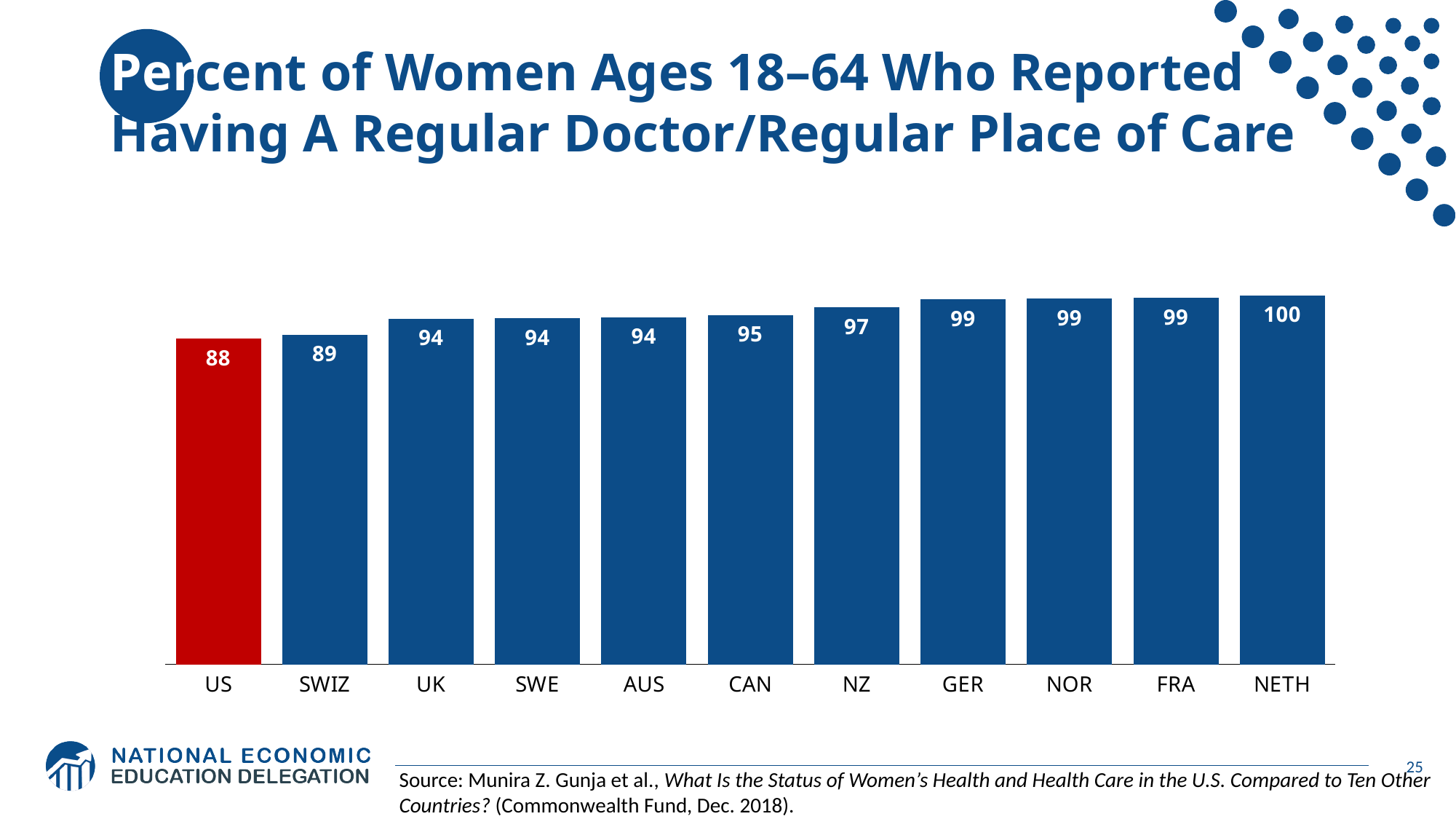
What is the value for CAN? 95 What is the value for the US? 88 What kind of chart is shown on the slide? bar chart Which bar is coloured red rather than blue? US How many countries are shown in the chart? 11 Which country has the lowest value? US Which country has the highest value? NETH Do the values rise or fall from left to right along the x axis? rise What is the difference between the values for NETH and the US? 12 Which is larger, the value for UK or the value for NZ? NZ What is the value for NZ? 97 What is the difference between the values for SWIZ and the US? 1